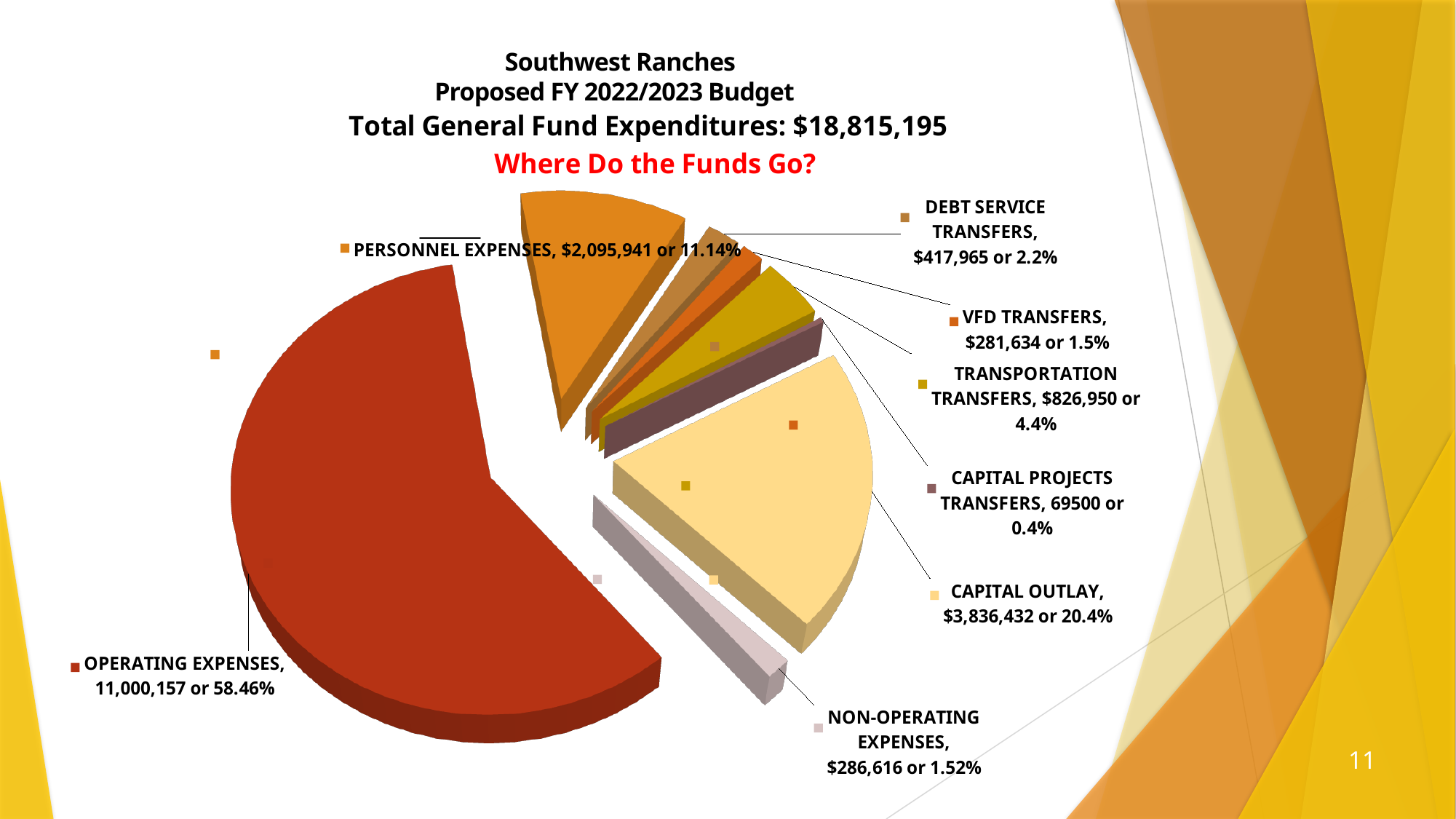
What is the total general fund expenditures figure stated in the chart title? $18,815,195 What is the difference between the Capital Outlay value and the Personnel Expenses value? $1,740,491 What is the red subtitle question shown above the pie chart? Where Do the Funds Go? What is the value shown for Transportation Transfers? $826,950 What percentage of the pie is Personnel Expenses? 11.14% Which category has the smallest share of the pie? Capital Projects Transfers Which category has the largest share of the pie? Operating Expenses How many slices does the pie chart have? 8 What percentage of the pie is Debt Service Transfers? 2.2% Which is larger, VFD Transfers or Non-Operating Expenses? Non-Operating Expenses What is the dollar value shown for Capital Outlay? $3,836,432 What kind of chart is shown on the slide? pie chart